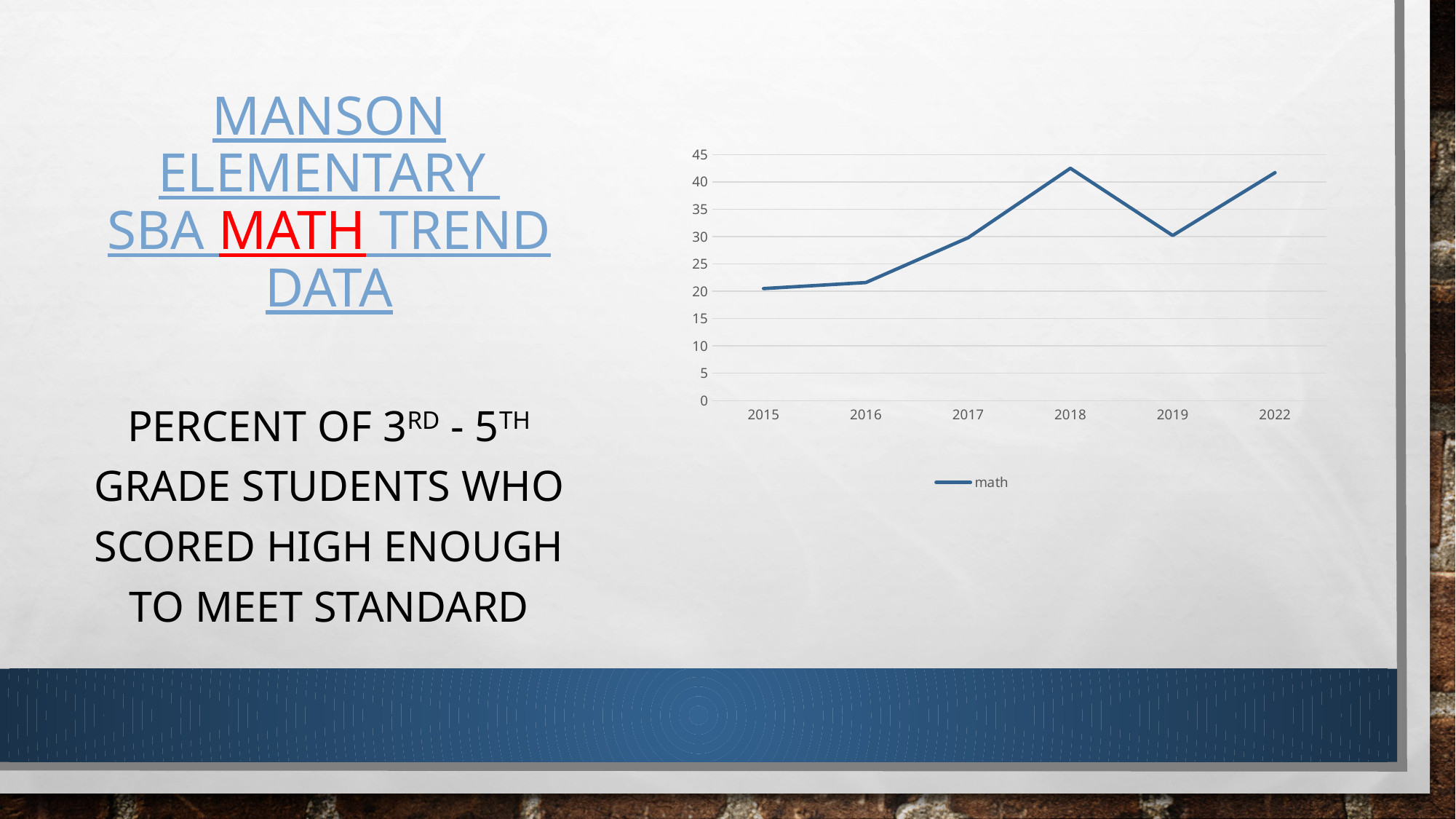
What is the name of the series shown in the chart's legend? math Is the value for 2015 greater or less than 25? less How many series does the chart's legend list? 1 How many years are plotted on the x axis of the chart? 6 Do the values rise or fall from 2015 to 2018? rise Is the value for 2017 greater or less than 25? greater What kind of chart is shown on the slide? line chart Is the value for 2018 greater or less than 40? greater Which year has a higher value, 2017 or 2022? 2022 Which year has a higher value, 2018 or 2019? 2018